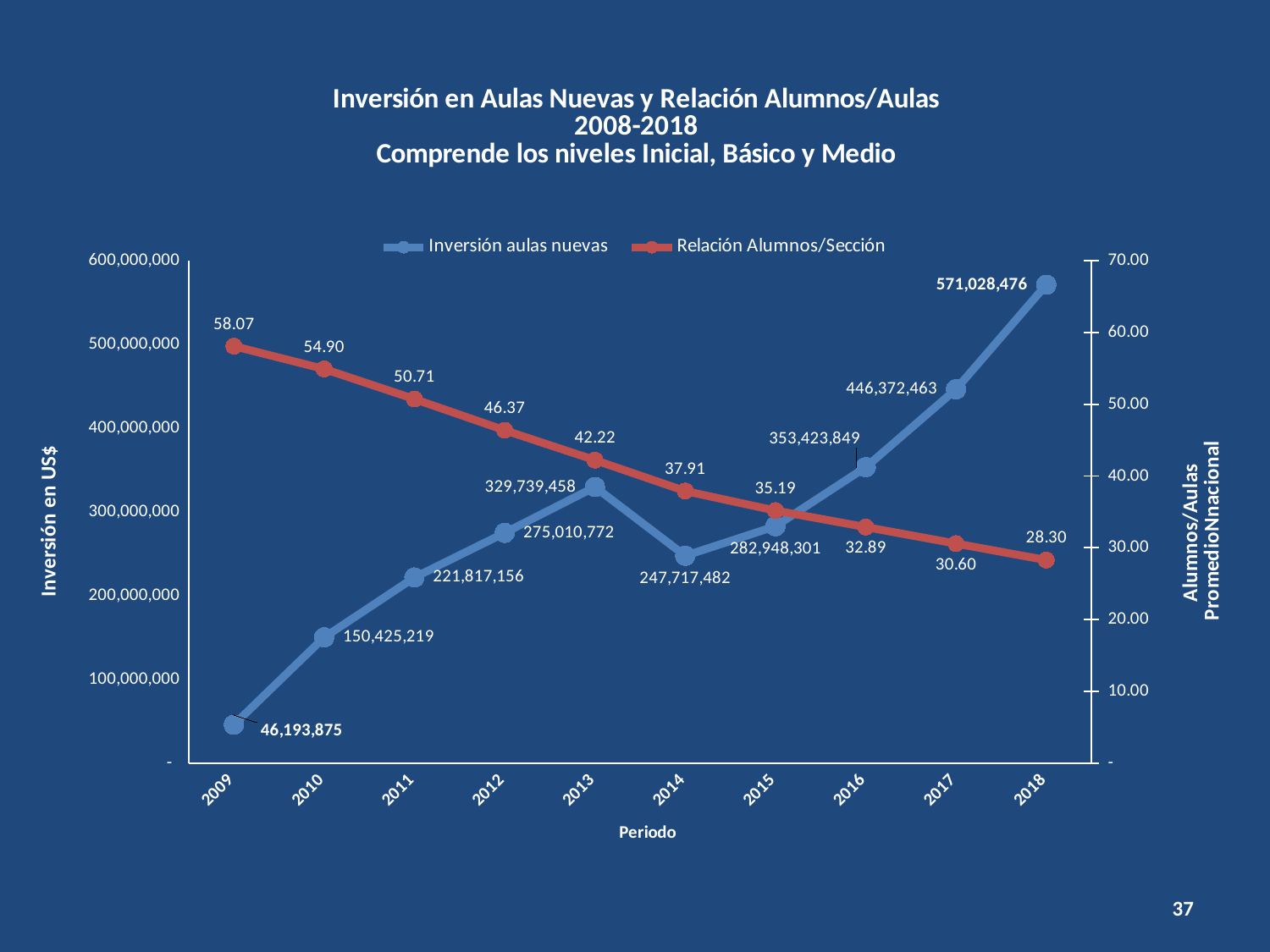
What is the Relación Alumnos/Sección value for 2012? 46.37 What is the difference in Relación Alumnos/Sección between 2009 and 2018? 29.77 How many years are plotted on the x axis? 10 Does the Relación Alumnos/Sección series rise or fall from 2009 to 2018? fall Which year has the highest Inversión aulas nuevas? 2018 Which year has a larger Inversión aulas nuevas, 2013 or 2014? 2013 Which year has the lowest Inversión aulas nuevas? 2009 Which year has the lowest Relación Alumnos/Sección? 2018 What is the value of Inversión aulas nuevas for 2014? 247,717,482 What is the value of Inversión aulas nuevas for 2018? 571,028,476 What is the difference in Inversión aulas nuevas between 2018 and 2017? 124,656,013 How many series does the legend list? 2